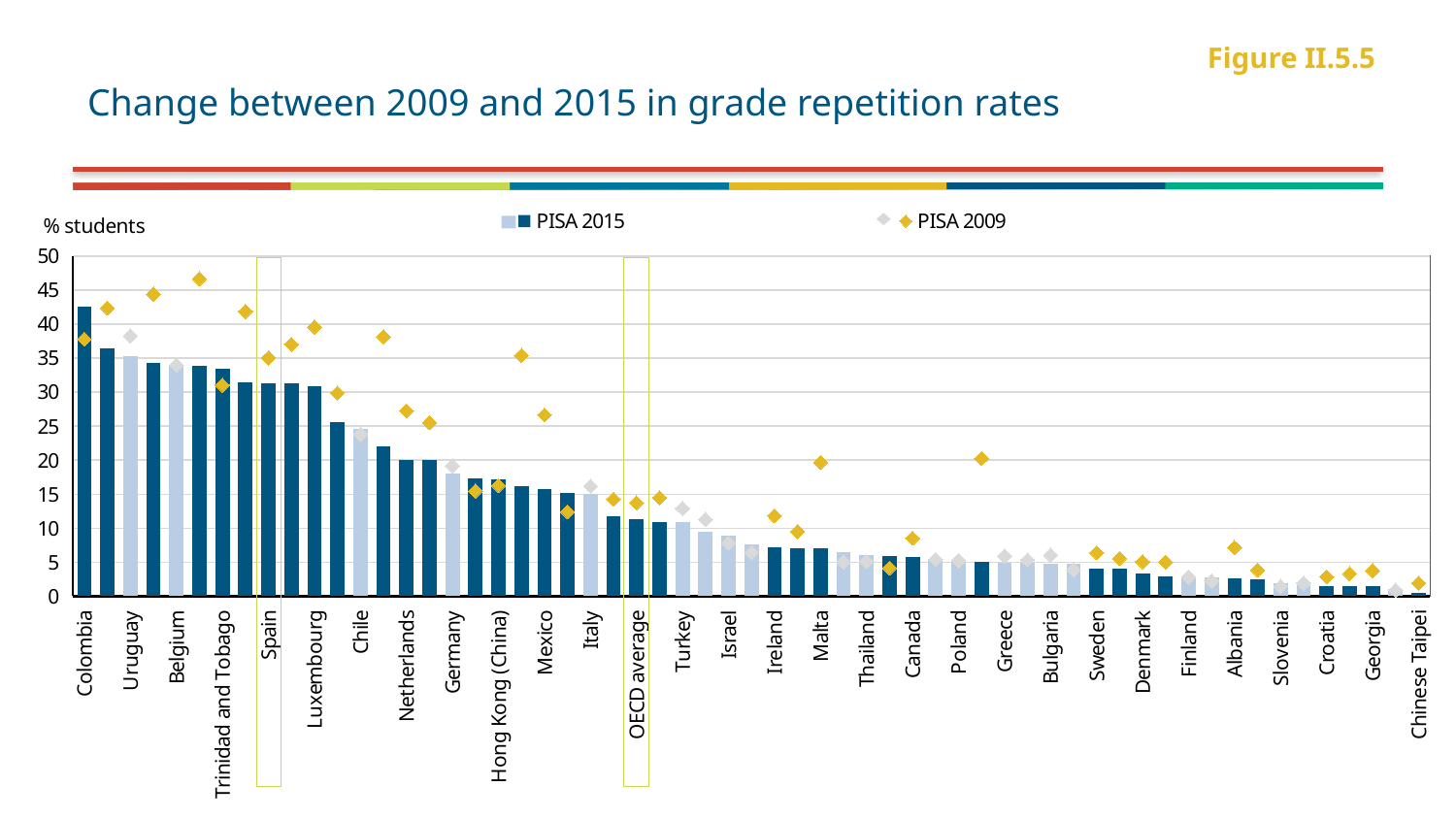
Is the PISA 2015 value for the OECD average greater or less than 15? less What is the label on the vertical axis? % students Is the PISA 2009 value for Malta greater or less than 15? greater Is the PISA 2015 value for Colombia greater or less than 40? greater What kind of chart is shown on the slide? bar chart How many series does the legend list? 2 Which is larger for Spain, the PISA 2009 value or the PISA 2015 value? PISA 2009 Which country has the highest PISA 2015 bar? Colombia What are the two series named in the legend? PISA 2015 and PISA 2009 Do the PISA 2015 bars rise or fall moving from left to right across the chart? fall